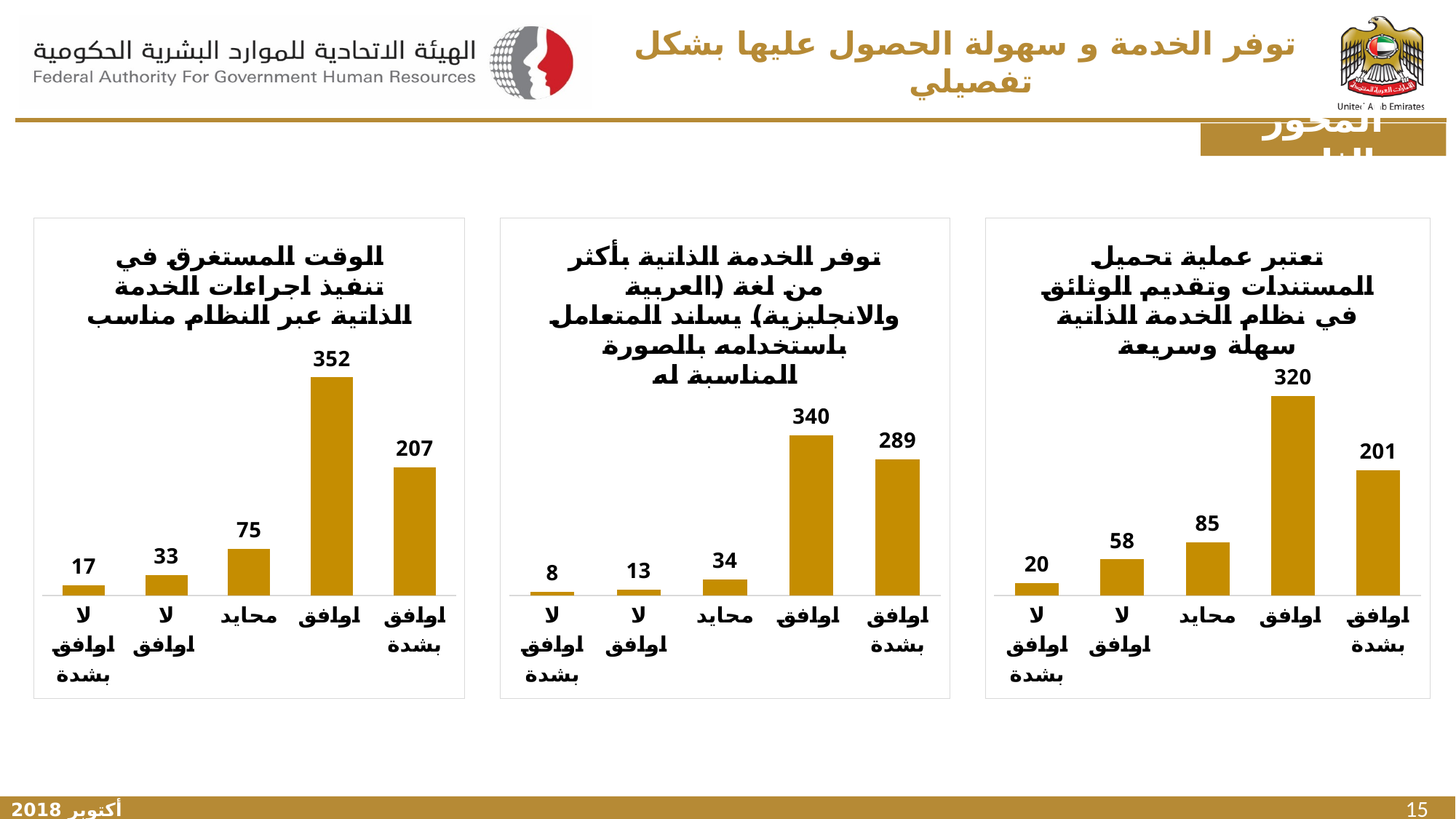
In the right chart, what is the difference between the values for "اوافق" and "محايد"? 235 In the middle chart, what is the value for the category "محايد" (Neutral)? 34 In the right chart, what is the value for the category "لا اوافق" (Disagree)? 58 In the left chart, what is the value for the category "اوافق" (Agree)? 352 In the middle chart, which category has the highest value? اوافق (Agree) In the left chart, what is the difference between the values for "اوافق" and "اوافق بشدة"? 145 How many charts are shown on the slide? 3 How many categories does the left chart show? 5 In the middle chart, what is the difference between the values for "اوافق" and "اوافق بشدة"? 51 In the left chart, which category has the lowest value? لا اوافق بشدة (Strongly disagree) In the right chart, which is larger: the value for "محايد" or the value for "لا اوافق"? محايد What type of chart is the middle chart? Bar chart